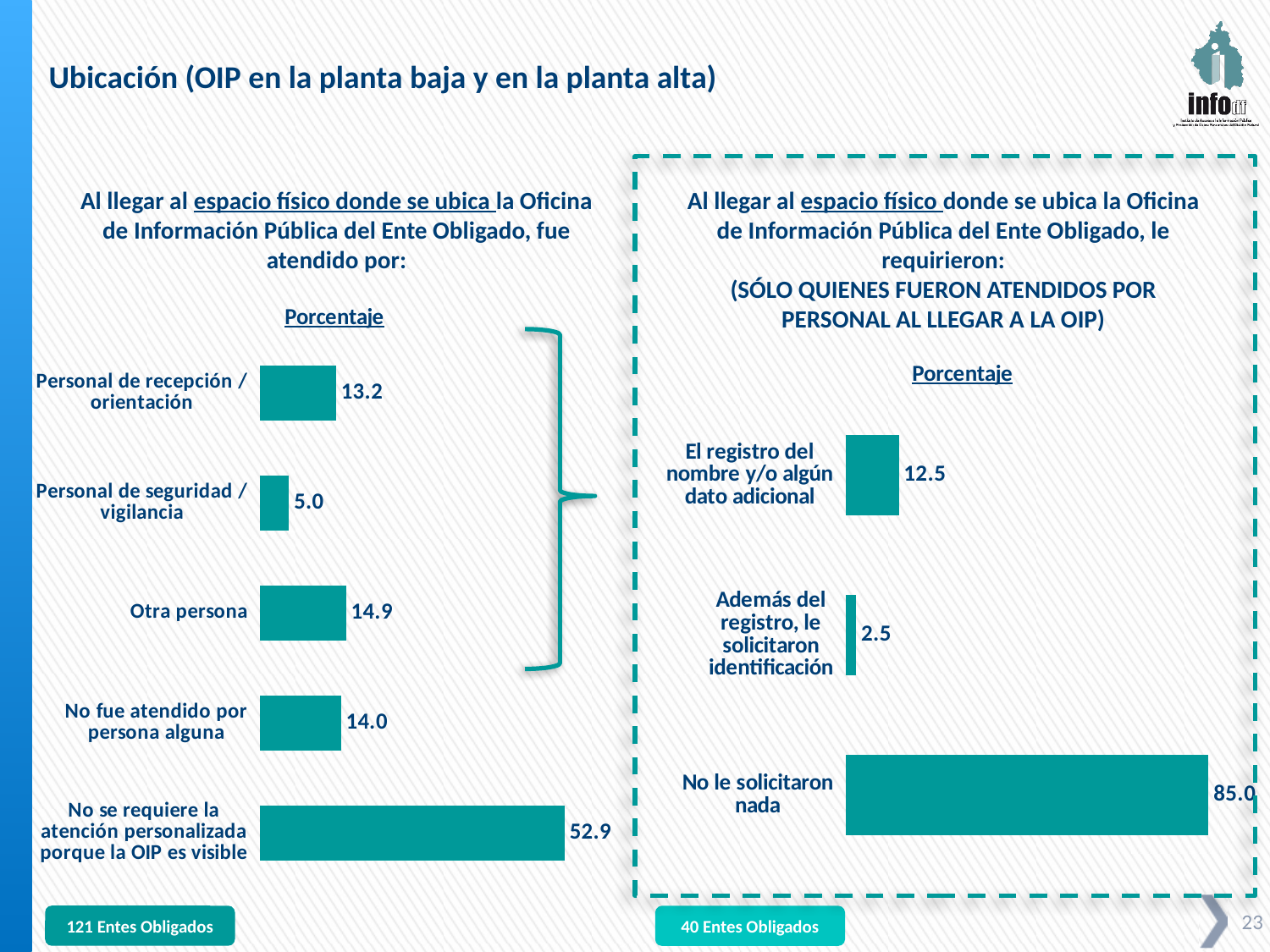
In the left chart, what is the value for 'Personal de recepción / orientación'? 13.2 In the left chart, how many categories are shown? 5 In the right chart, which is larger: 'El registro del nombre y/o algún dato adicional' or 'Además del registro, le solicitaron identificación'? El registro del nombre y/o algún dato adicional In the right chart, how many categories are shown? 3 In the right chart, what is the value for 'No le solicitaron nada'? 85.0 What type of chart is the left chart? Bar chart In the right chart, what is the value for 'Además del registro, le solicitaron identificación'? 2.5 In the right chart, what is the difference between 'No le solicitaron nada' and 'El registro del nombre y/o algún dato adicional'? 72.5 In the left chart, which category has the highest value? No se requiere la atención personalizada porque la OIP es visible In the left chart, what is the value for 'Personal de seguridad / vigilancia'? 5.0 In the left chart, which category has the lowest value? Personal de seguridad / vigilancia In the left chart, what is the difference between the values for 'Otra persona' and 'No fue atendido por persona alguna'? 0.9